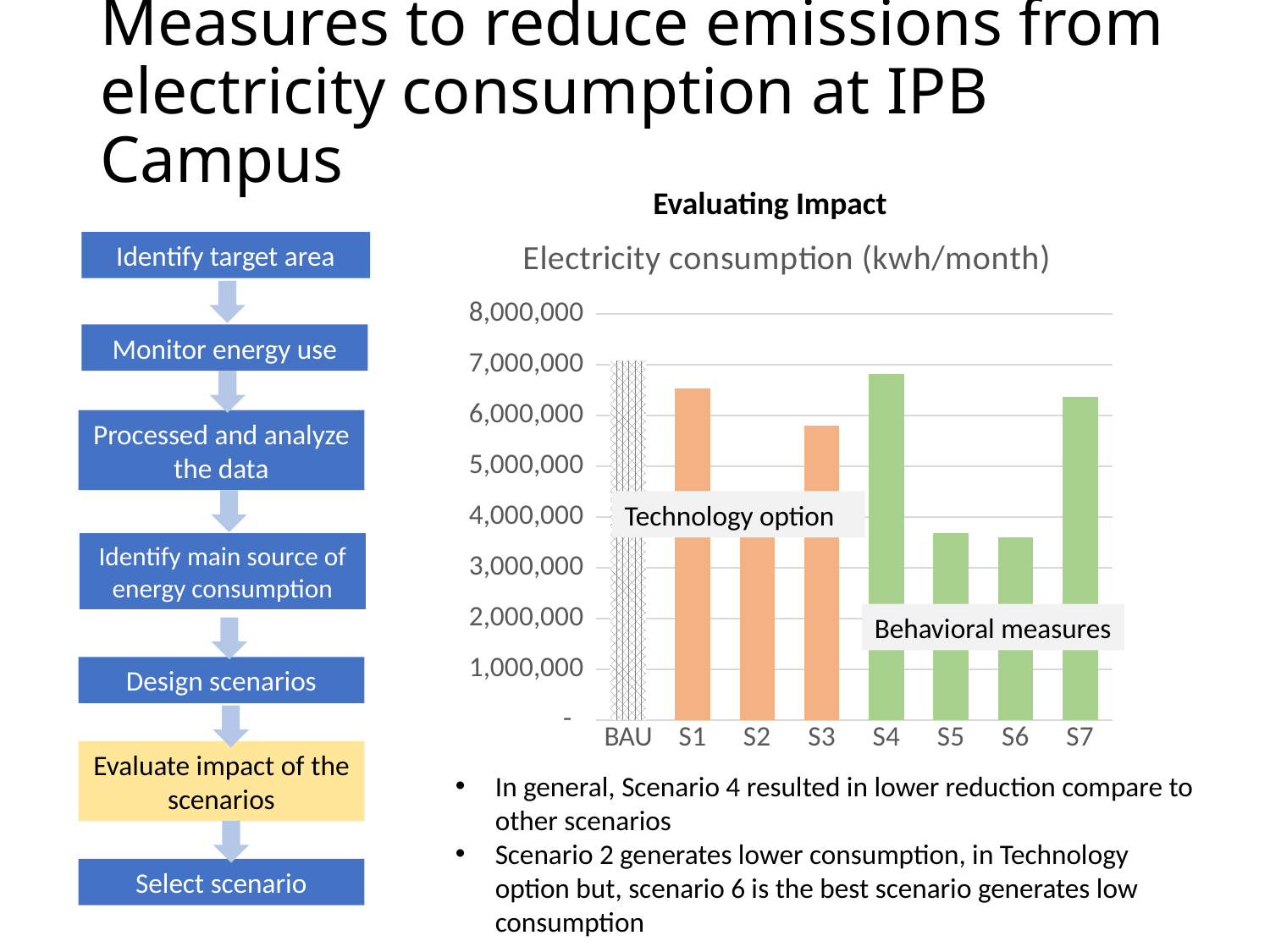
Is the value for S6 greater or less than 4,000,000? less What kind of chart is shown on the slide? Bar chart How many categories are plotted on the x axis of the chart? 8 What is the title of the chart? Electricity consumption (kwh/month) Is the value for S1 greater or less than 6,000,000? greater Which has the larger electricity consumption, S1 or S3? S1 Which group of scenarios is labelled 'Behavioral measures' in the chart? S4 to S7 (the green bars) Is the value for S3 greater or less than 6,000,000? less Which category has the highest electricity consumption in the chart? BAU Which has the larger electricity consumption, S4 or S5? S4